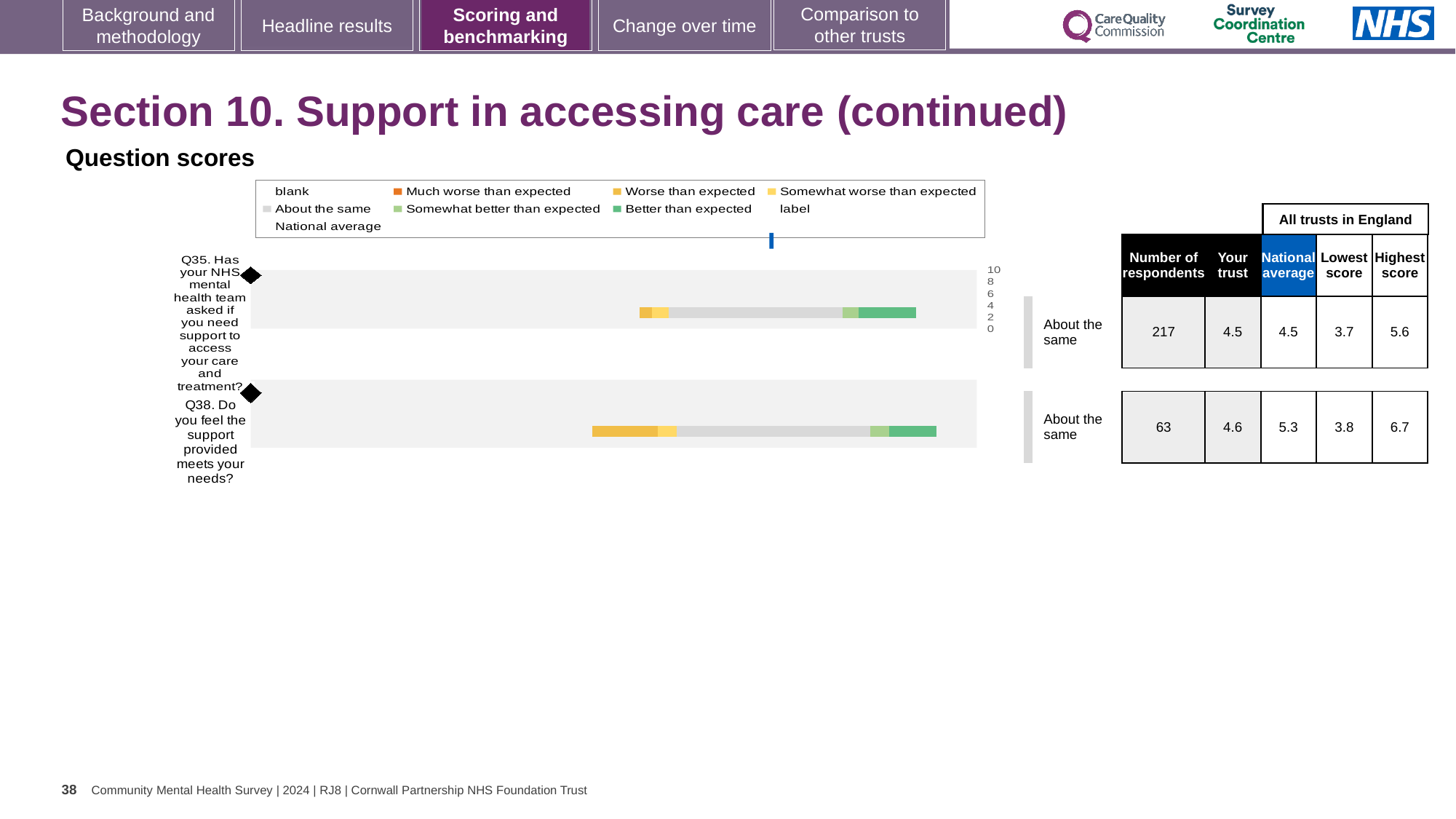
What is the 'Your trust' score for Q38 (Do you feel the support provided meets your needs?)? 4.6 How many respondents answered Q35? 217 For Q38, is the 'Your trust' score higher or lower than the national average? lower What kind of chart is used to show the question scores on this slide? bar chart Which question had more respondents, Q35 or Q38? Q35 What benchmark category is shown next to the bar for Q35? About the same What is the difference between the highest score and the lowest score for Q35? 1.9 What is the 'Your trust' score for Q35 (Has your NHS mental health team asked if you need support to access your care and treatment?)? 4.5 How many questions are plotted in the question scores chart? 2 What is the highest score among all trusts in England for Q38? 6.7 What is the lowest score among all trusts in England for Q38? 3.8 What is the national average score for Q38? 5.3